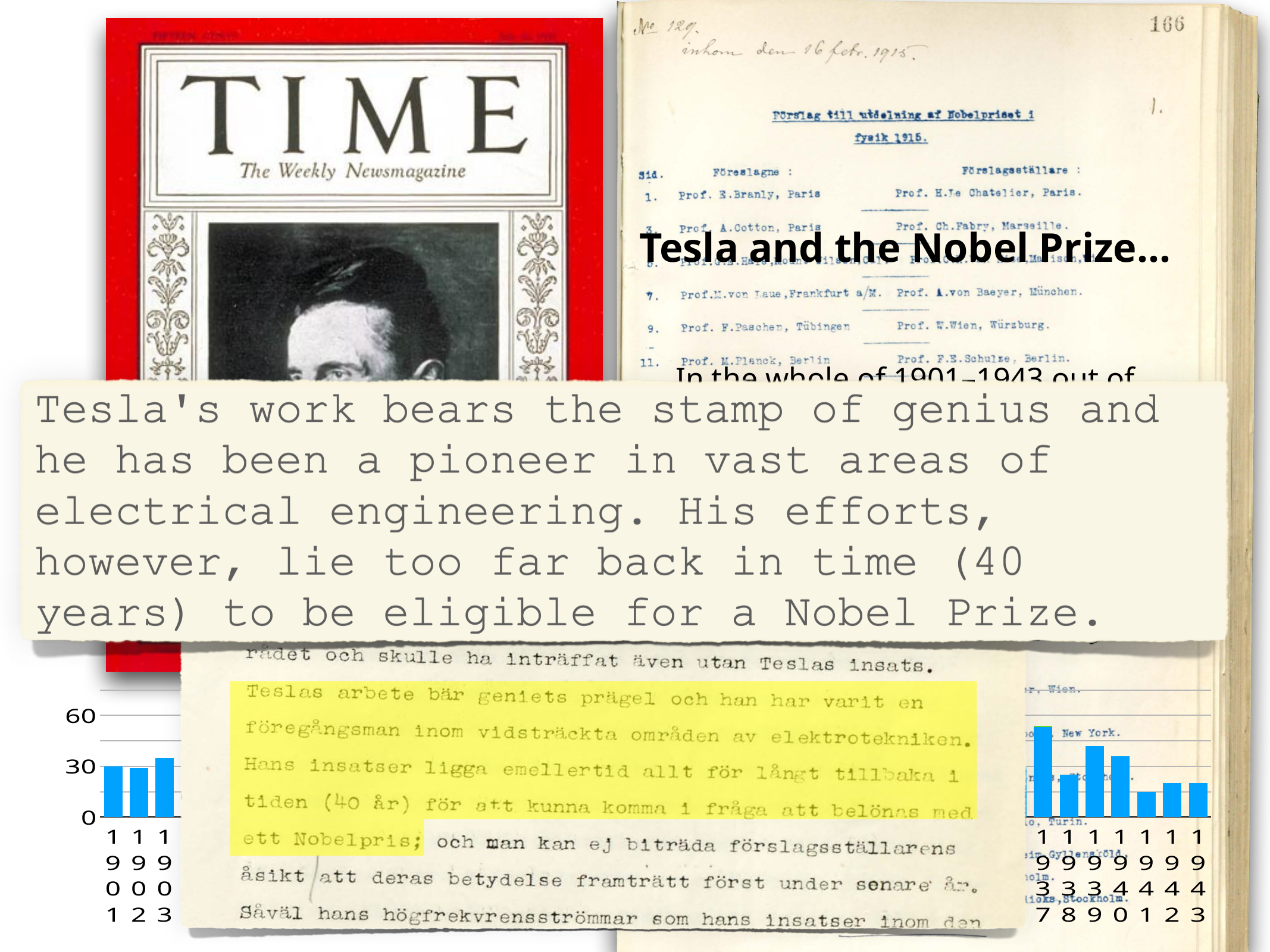
In the bar chart, is the value for 1943 greater or less than 30? less In the bar chart, which is larger, the value for 1938 or the value for 1941? 1938 In the bar chart, is the value for 1939 greater or less than 30? greater In the bar chart, is the value for 1938 greater or less than 30? less What is the highest value labelled on the y axis of the bar chart? 60 What kind of chart is shown at the bottom of the slide? bar chart In the bar chart, which of the years 1937 to 1943 has the highest bar? 1937 What colour are the bars in the bar chart? blue In the bar chart, which is larger, the value for 1939 or the value for 1942? 1939